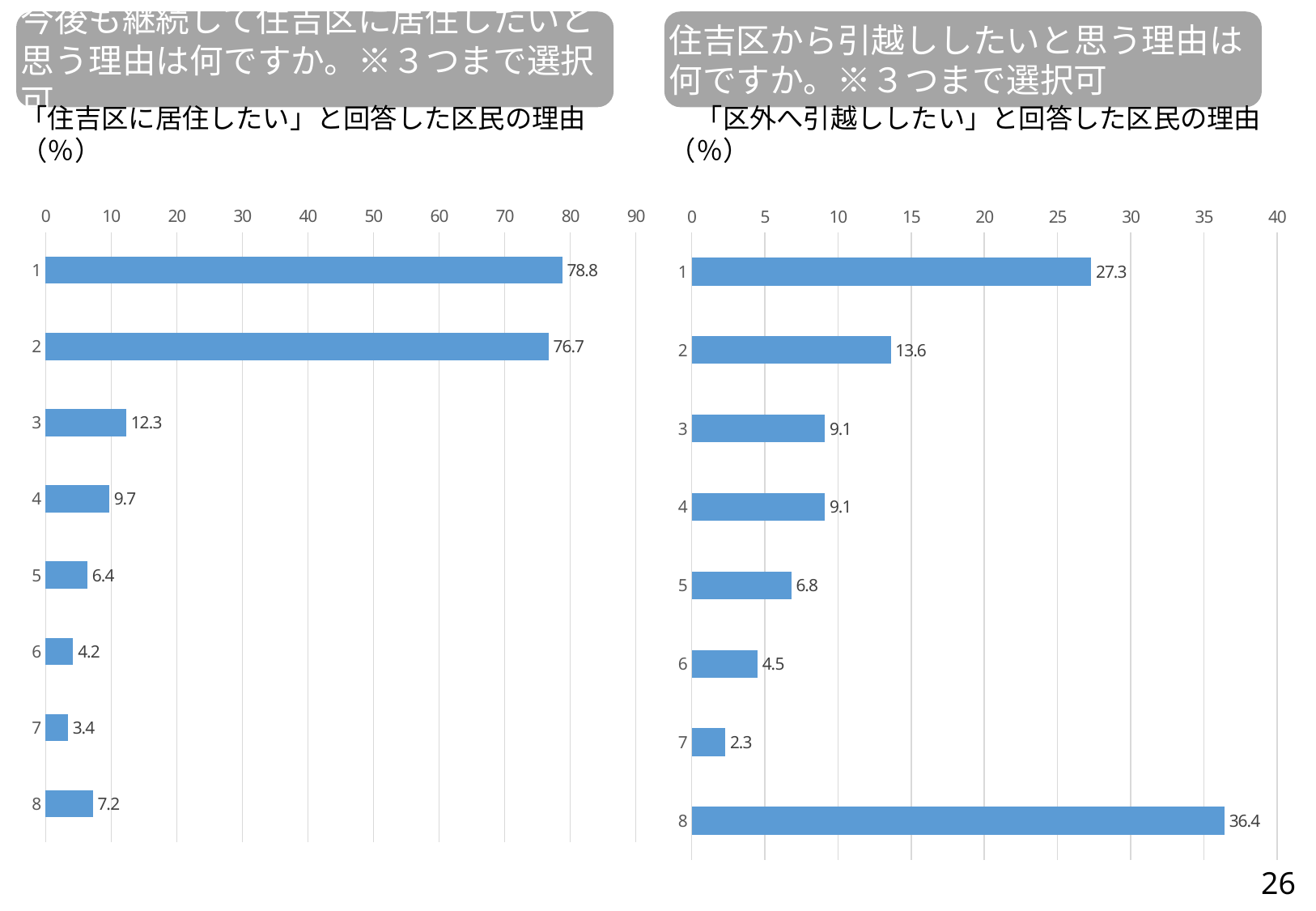
In the right chart (「区外へ引越ししたい」と回答した区民の理由), which category has the lowest value? 7 In the right chart (「区外へ引越ししたい」と回答した区民の理由), is the value for category 2 larger or smaller than the value for category 5? larger What kind of chart is the left chart (「住吉区に居住したい」と回答した区民の理由)? bar chart In the left chart (「住吉区に居住したい」と回答した区民の理由), what is the difference between the values for category 1 and category 2? 2.1 In the left chart (「住吉区に居住したい」と回答した区民の理由), which category has the lowest value? 7 In the left chart (「住吉区に居住したい」と回答した区民の理由), what is the value for category 3? 12.3 In the left chart (「住吉区に居住したい」と回答した区民の理由), how many categories are plotted? 8 In the left chart (「住吉区に居住したい」と回答した区民の理由), what is the value for category 1? 78.8 In the right chart (「区外へ引越ししたい」と回答した区民の理由), what is the value for category 8? 36.4 In the right chart (「区外へ引越ししたい」と回答した区民の理由), what is the difference between the values for category 8 and category 1? 9.1 In the right chart (「区外へ引越ししたい」と回答した区民の理由), what is the maximum value shown on the horizontal axis? 40 In the right chart (「区外へ引越ししたい」と回答した区民の理由), which category has the highest value? 8